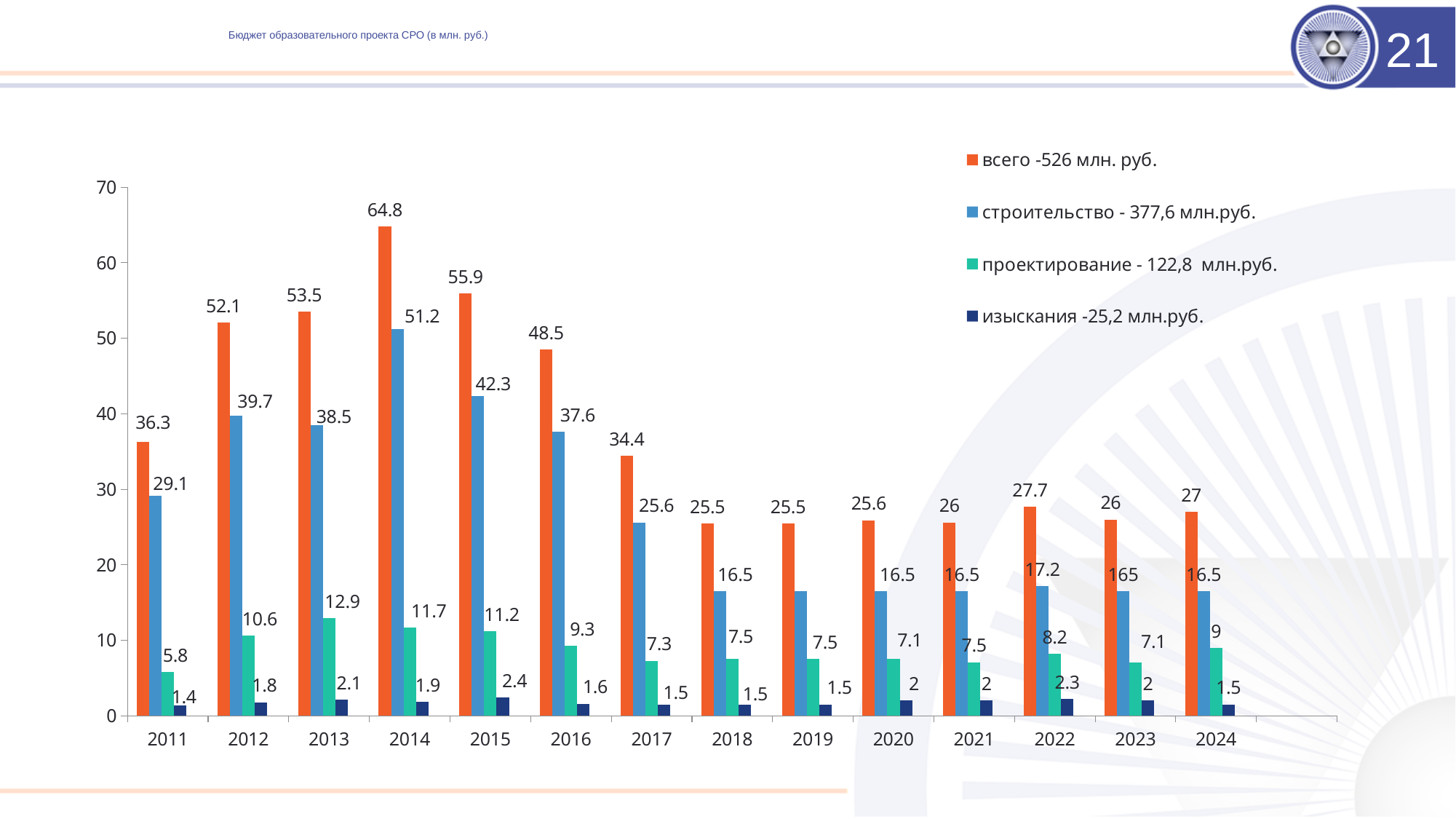
What is the value of the всего series for 2014? 64.8 In which year is the всего series highest? 2014 How many years are shown on the x axis? 14 What kind of chart is shown on the slide? bar chart Does the всего series rise or fall from 2014 to 2018? fall What is the value of the изыскания series for 2022? 2.3 In which year is the проектирование series lowest? 2011 What is the value of the проектирование series for 2013? 12.9 What is the value of the строительство series for 2015? 42.3 Which is larger: the строительство value for 2012 or for 2013? 2012 What is the difference between the всего values for 2014 and 2011? 28.5 How many series does the legend list? 4